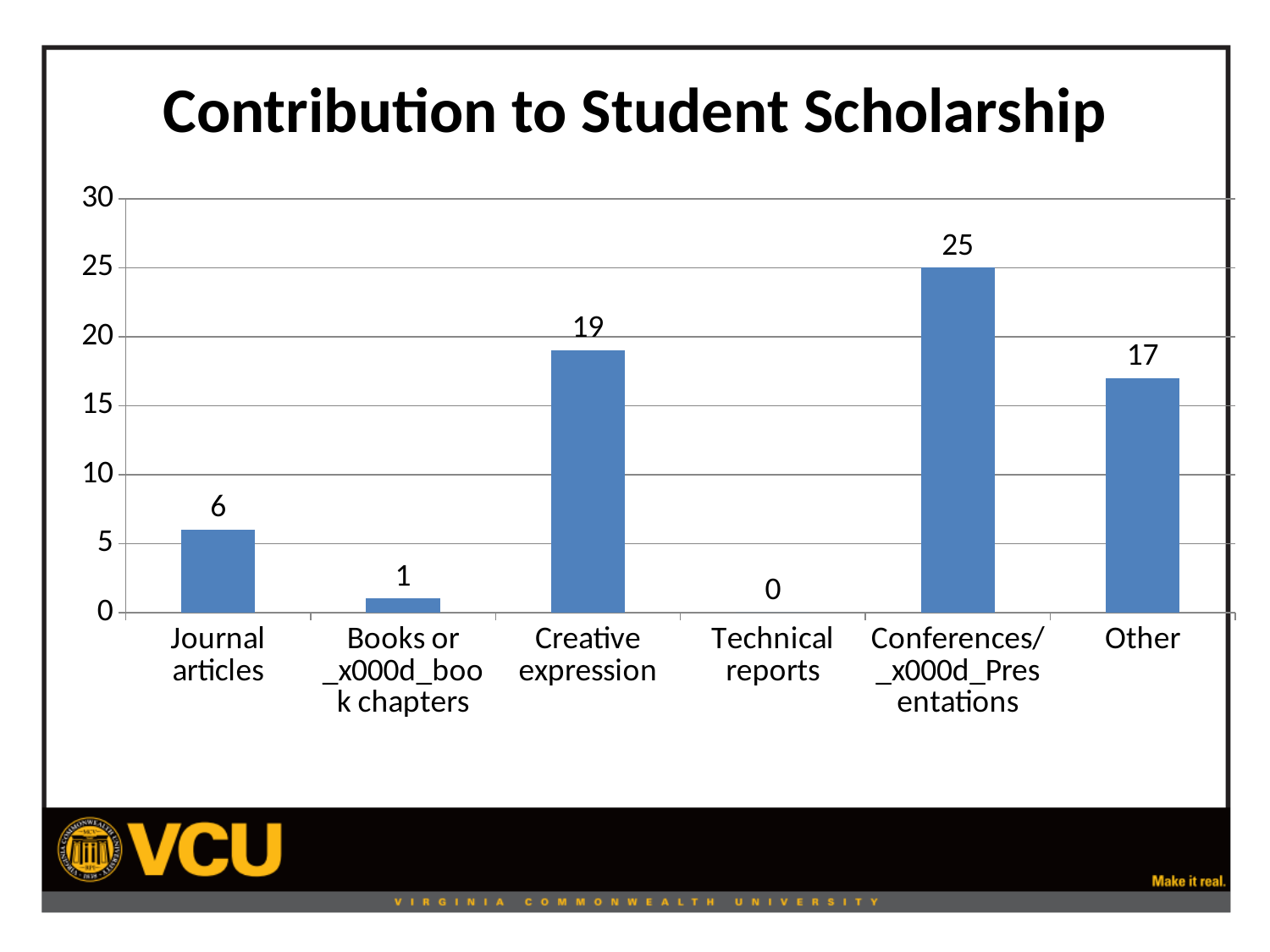
What is the title of the chart? Contribution to Student Scholarship Which is larger, the value for Journal articles or the value for Books or book chapters? Journal articles What is the value for Journal articles? 6 What is the difference between the values for Conferences/Presentations and Other? 8 Which category has the highest value? Conferences/Presentations What is the value for Other? 17 What kind of chart is this? Bar chart Which category has the lowest value? Technical reports How many categories are shown on the x axis? 6 What is the difference between the values for Creative expression and Journal articles? 13 What is the value for Creative expression? 19 What is the value for Technical reports? 0